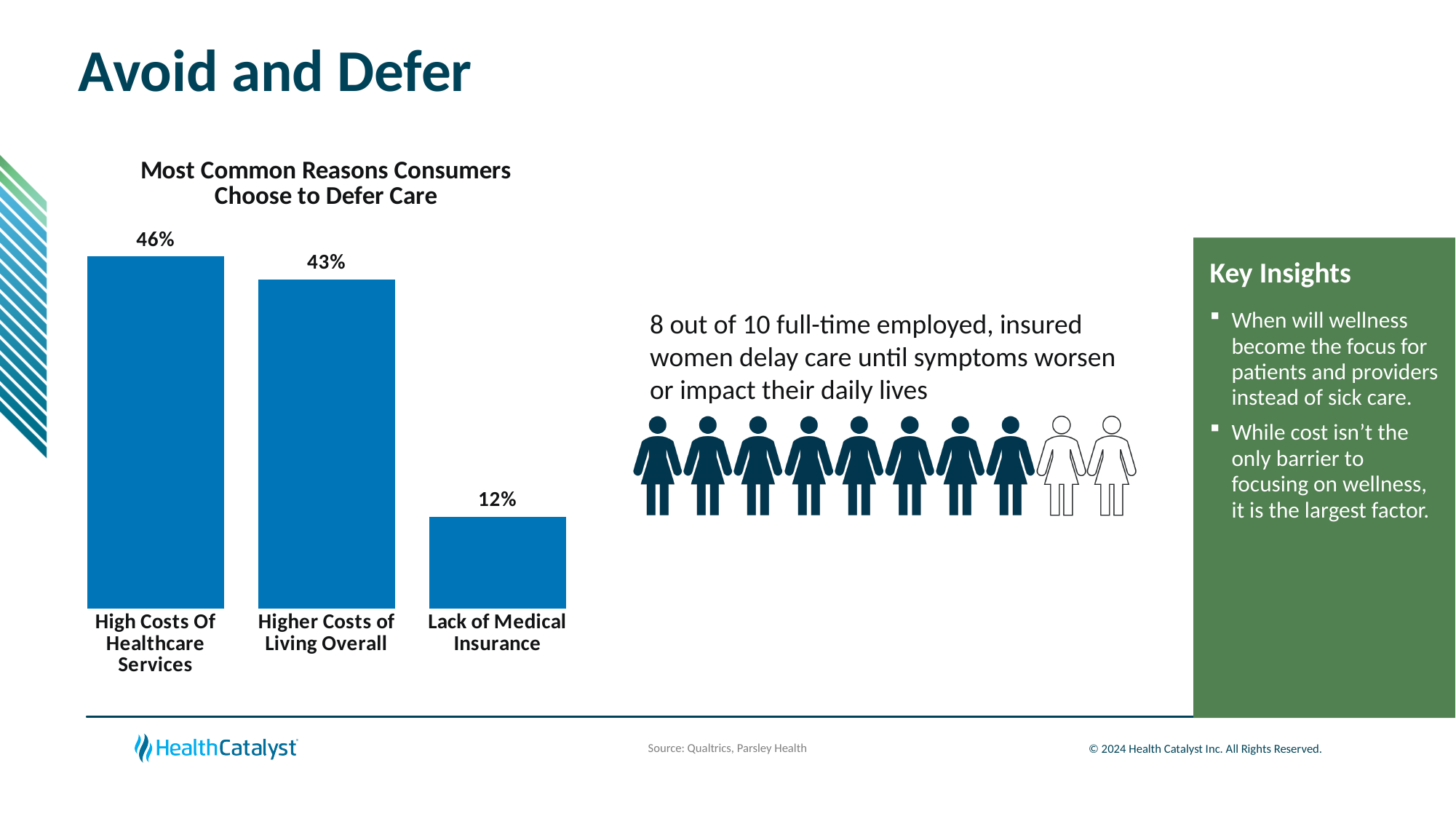
Do the values rise or fall from left to right across the chart? Fall How many categories are shown in the chart? 3 What is the difference between High Costs Of Healthcare Services and Higher Costs of Living Overall? 3% What kind of chart is shown on the slide? Bar chart Which reason has the highest value? High Costs Of Healthcare Services What is the title of the chart? Most Common Reasons Consumers Choose to Defer Care Which reason has the lowest value? Lack of Medical Insurance What is the value for Lack of Medical Insurance? 12% What is the value for High Costs Of Healthcare Services? 46% What is the difference between High Costs Of Healthcare Services and Lack of Medical Insurance? 34% What is the value for Higher Costs of Living Overall? 43% Which is larger, Higher Costs of Living Overall or Lack of Medical Insurance? Higher Costs of Living Overall